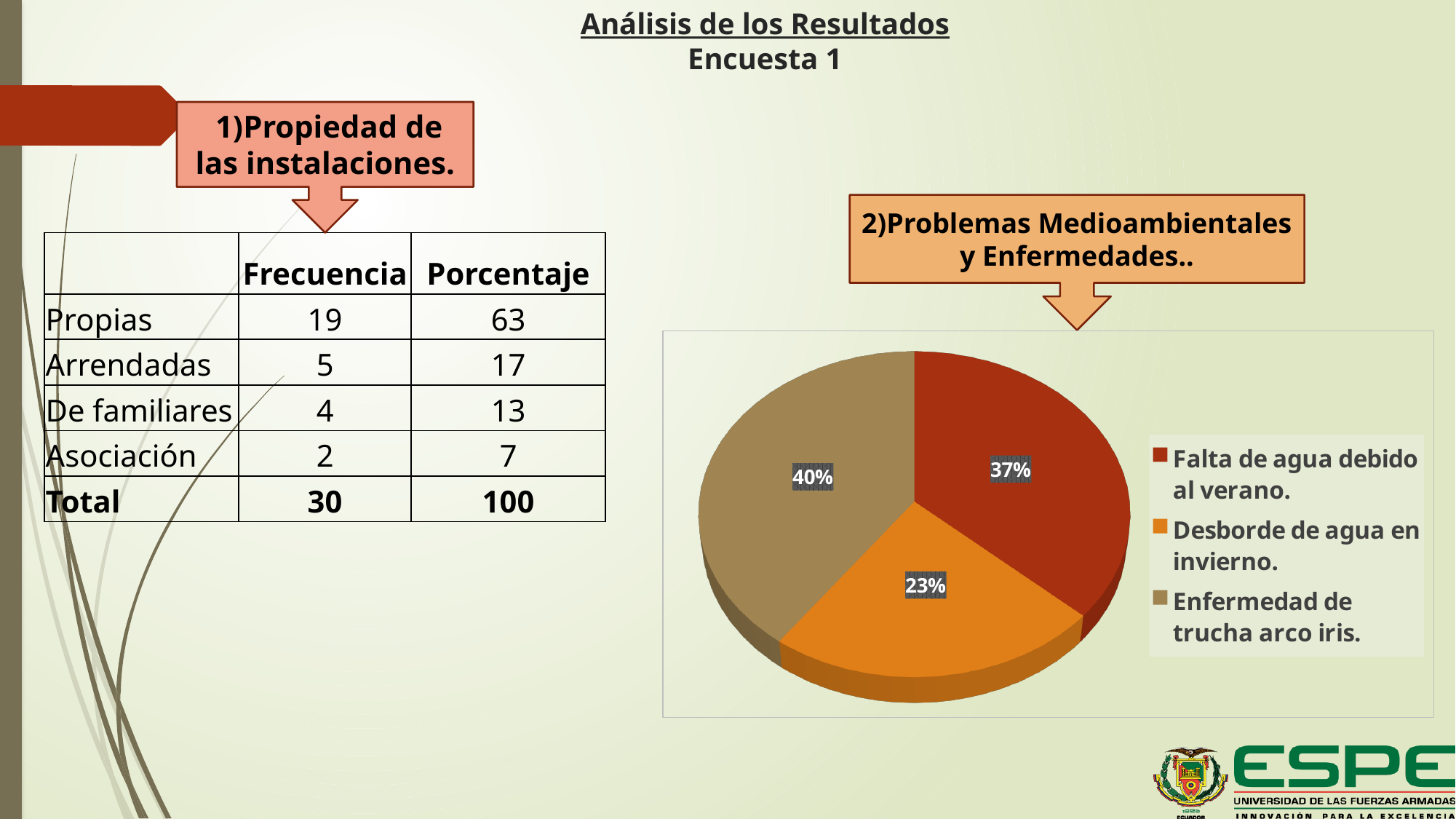
How many entries does the pie chart's legend list? 3 How many slices does the pie chart have? 3 Which category has the largest slice in the pie chart? Enfermedad de trucha arco iris. What is the difference in percentage points between the "Enfermedad de trucha arco iris." slice and the "Desborde de agua en invierno." slice? 17 What is the difference in percentage points between the "Enfermedad de trucha arco iris." slice and the "Falta de agua debido al verano." slice? 3 What kind of chart is shown on the slide? pie chart Which category has the smallest slice in the pie chart? Desborde de agua en invierno. Which is larger in the pie chart: "Falta de agua debido al verano." or "Desborde de agua en invierno."? Falta de agua debido al verano. What colour is the "Desborde de agua en invierno." slice in the pie chart? orange What share of the pie chart does "Falta de agua debido al verano." represent? 37% What share of the pie chart does "Enfermedad de trucha arco iris." represent? 40% What share of the pie chart does "Desborde de agua en invierno." represent? 23%